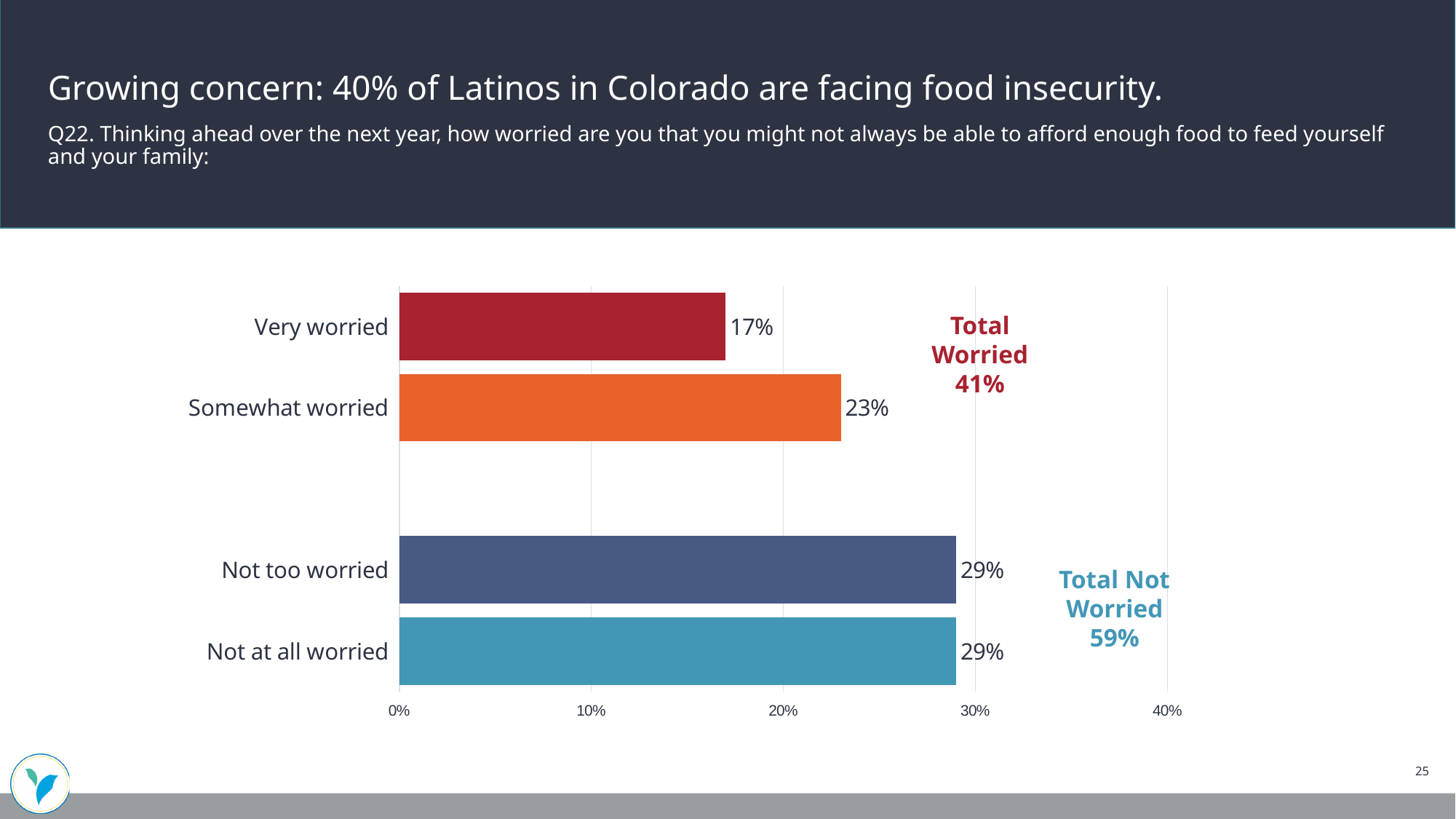
What percentage of respondents said they are not at all worried? 29% Which is larger, the percentage for not too worried or the percentage for somewhat worried? Not too worried What is the Total Not Worried percentage shown on the chart? 59% What is the Total Worried percentage shown on the chart? 41% What kind of chart is shown on the slide? Bar chart How many response categories are shown in the chart? 4 What is the highest value shown on the x axis? 40% What is the difference between the percentages for somewhat worried and very worried? 6% Which response category has the lowest percentage? Very worried What percentage of respondents said they are very worried? 17% What percentage of respondents said they are somewhat worried? 23% What percentage of respondents said they are not too worried? 29%